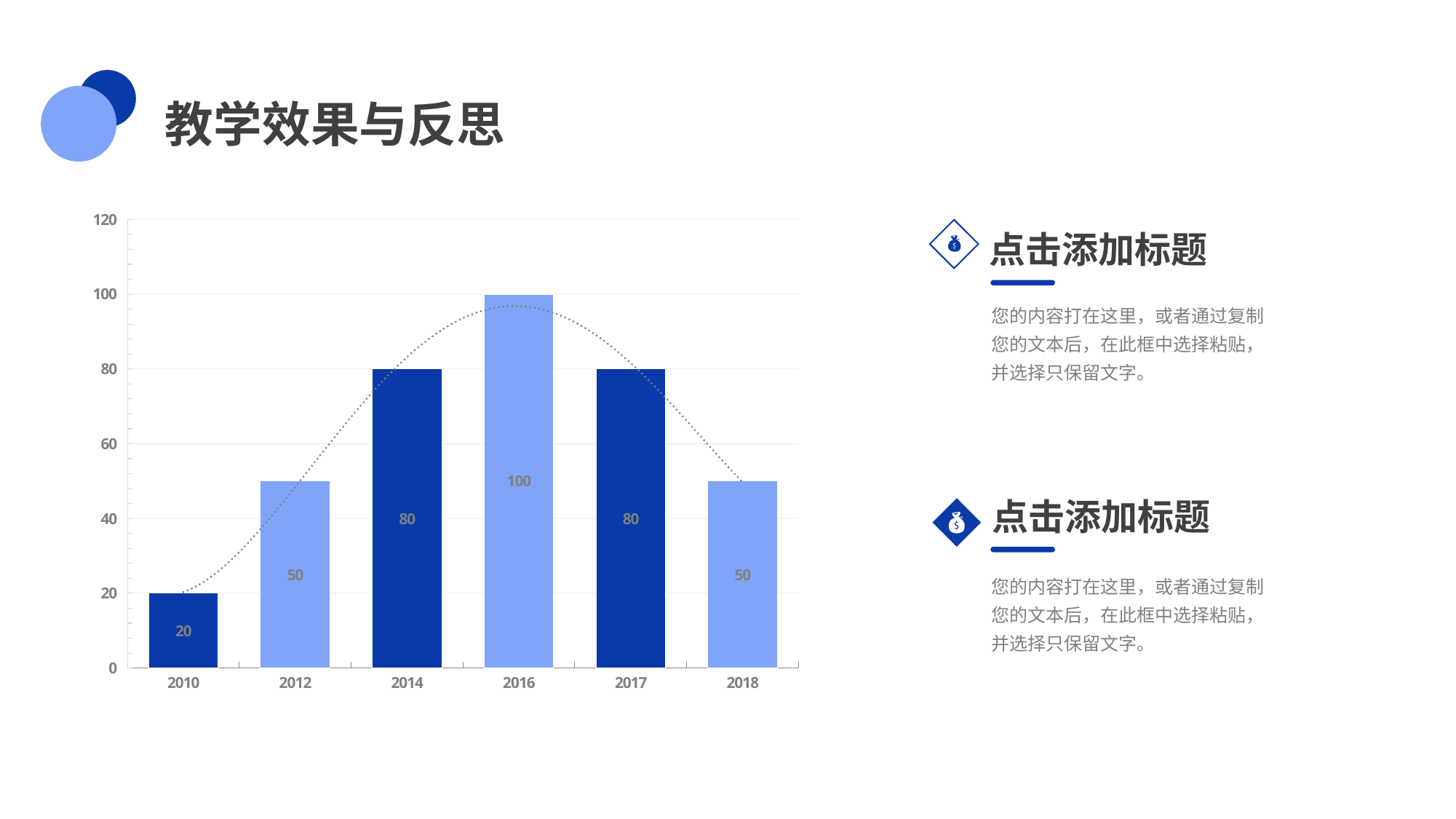
How many years are shown on the x axis? 6 Which year has the highest value? 2016 Is the value for 2017 greater or less than 60? greater What is the value for 2016? 100 What is the difference between the values for 2016 and 2012? 50 Do the values rise or fall from 2010 to 2016? rise What is the value for 2010? 20 Which is larger, the value for 2014 or the value for 2018? 2014 What is the highest value shown on the y axis? 120 Which year has the lowest value? 2010 What kind of chart is shown on the slide? bar chart What is the value for 2018? 50